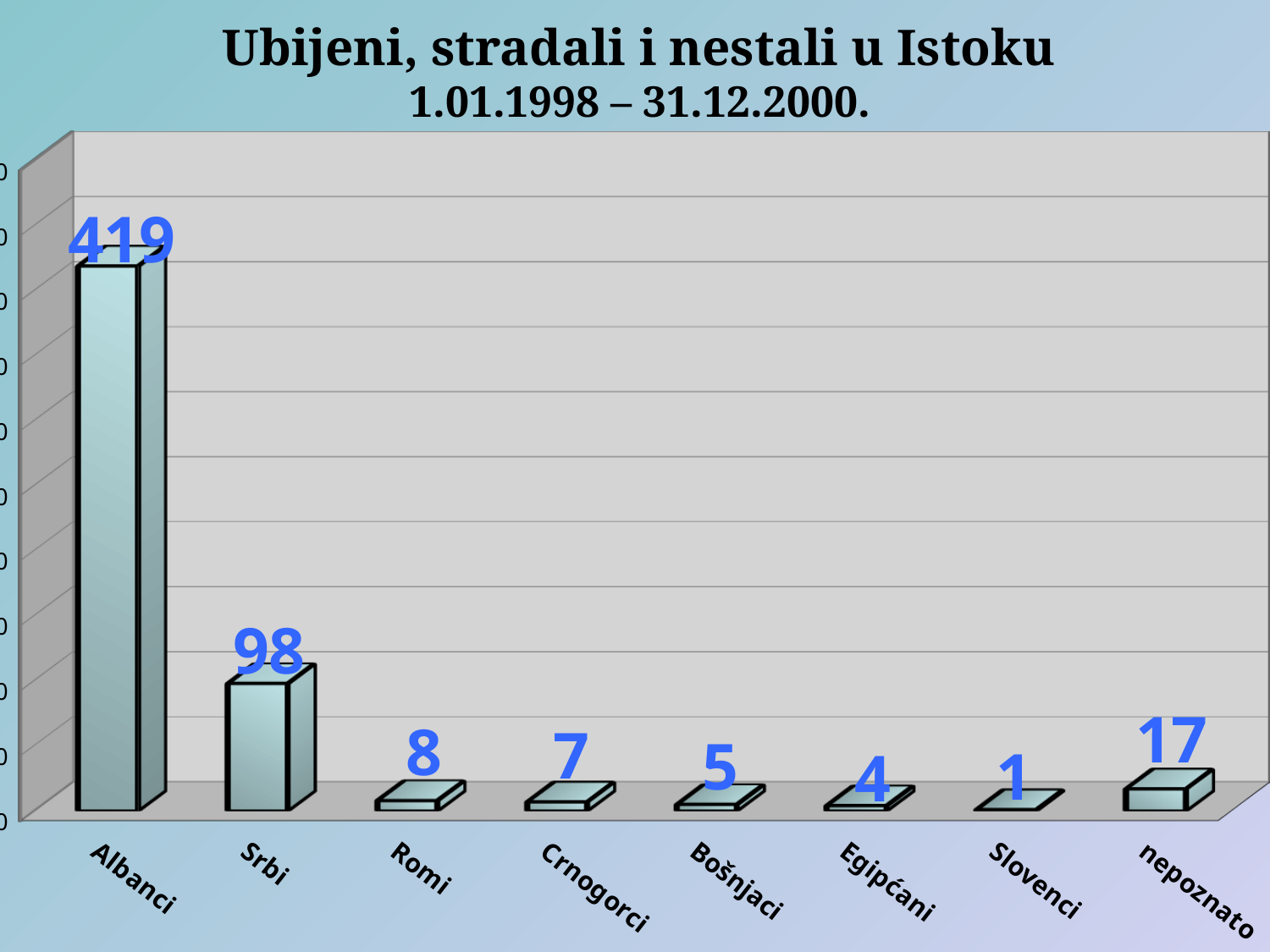
What is the value for Albanci? 419 Which category has the highest value? Albanci What is the value for Bošnjaci? 5 What is the value for Srbi? 98 What is the difference between the values for nepoznato and Egipćani? 13 Which is larger, the value for Romi or the value for Crnogorci? Romi What is the difference between the values for Albanci and Srbi? 321 What kind of chart is shown on the slide? bar chart Which category has the lowest value? Slovenci How many categories are shown on the x axis? 8 What date range is given in the chart's subtitle? 1.01.1998 – 31.12.2000. What is the value for nepoznato? 17